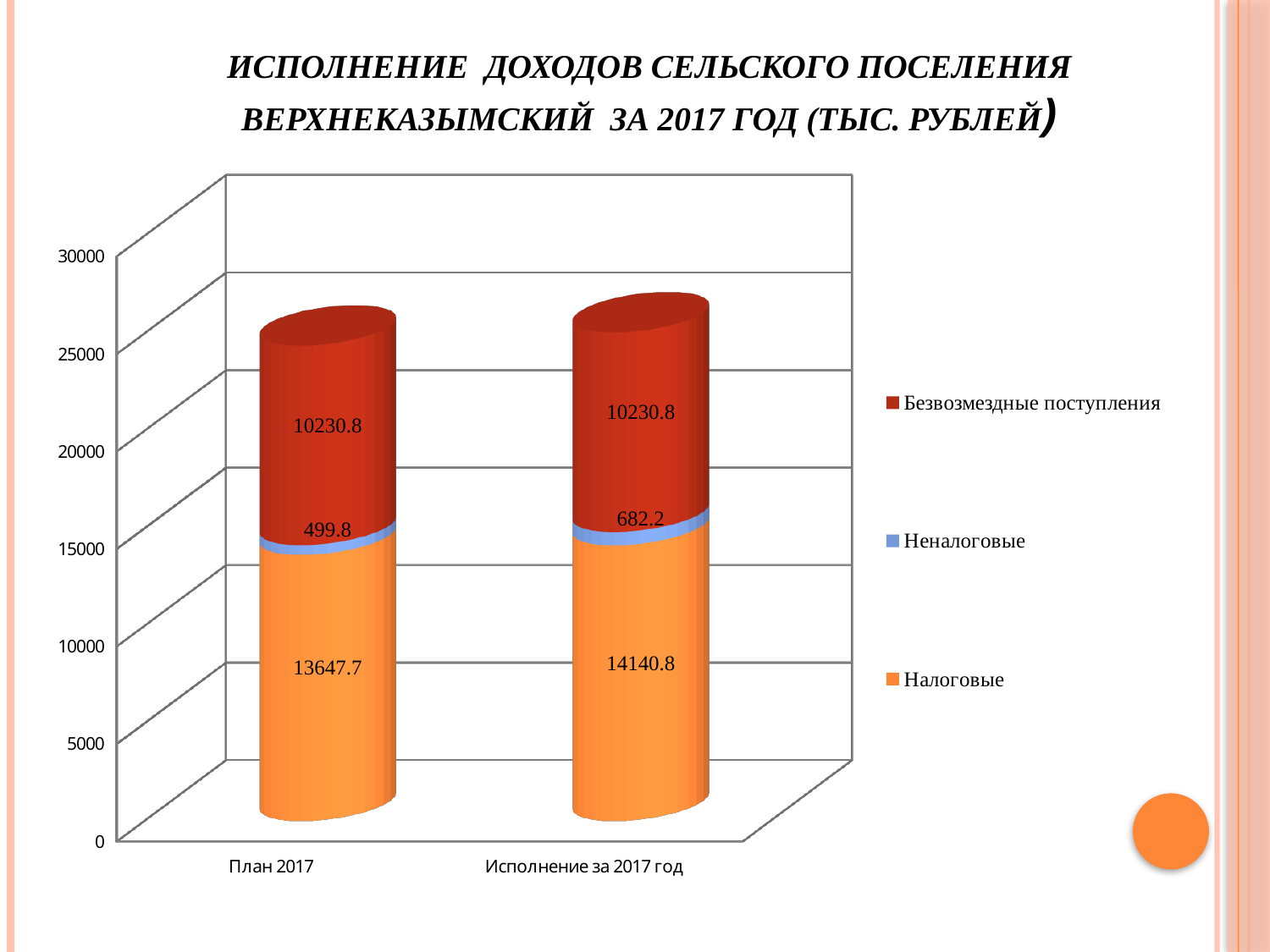
What is the difference between the Налоговые values for Исполнение за 2017 год and План 2017? 493.1 What is the value of Налоговые for План 2017? 13647.7 What is the difference between the Неналоговые values for Исполнение за 2017 год and План 2017? 182.4 How many categories are shown on the x axis? 2 What is the value of Налоговые for Исполнение за 2017 год? 14140.8 How many series does the legend list? 3 What is the value of Безвозмездные поступления for План 2017? 10230.8 What is the total of the stacked bar for Исполнение за 2017 год? 25053.8 What is the total of the stacked bar for План 2017? 24378.3 Which is larger, the Неналоговые value for План 2017 or for Исполнение за 2017 год? Исполнение за 2017 год What is the value of Неналоговые for Исполнение за 2017 год? 682.2 What kind of chart is shown on the slide? Stacked bar chart